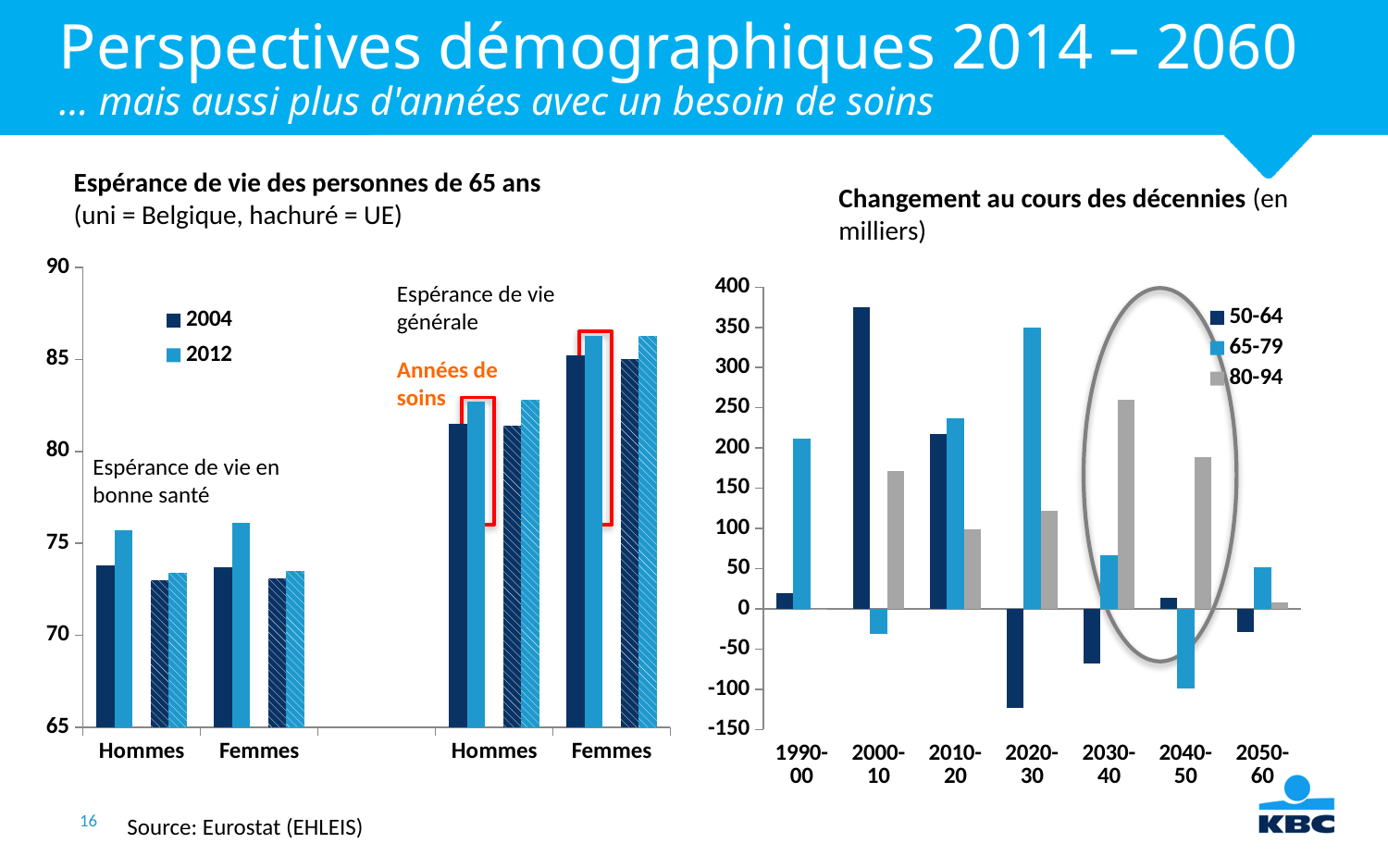
What type of chart is the 'Changement au cours des décennies' chart on the right? bar chart How many series does the legend of the right chart ('Changement au cours des décennies') list? 3 In the right chart ('Changement au cours des décennies'), is the value for the 65-79 series in 2040-50 greater or less than -50? less In the right chart ('Changement au cours des décennies'), which decade has the highest value for the 50-64 series? 2000-10 In the right chart ('Changement au cours des décennies'), which decade has the highest value for the 80-94 series? 2030-40 How many series does the legend of the left chart ('Espérance de vie des personnes de 65 ans') list? 2 In the right chart ('Changement au cours des décennies'), which decade has the lowest value for the 50-64 series? 2020-30 In the right chart ('Changement au cours des décennies'), for the decade 2030-40, which series has the larger value: 65-79 or 80-94? 80-94 In the right chart ('Changement au cours des décennies'), which decade has the highest value for the 65-79 series? 2020-30 How many decades are shown on the x axis of the right chart ('Changement au cours des décennies')? 7 In the right chart ('Changement au cours des décennies'), is the value for the 50-64 series in 2000-10 greater or less than 350? greater In the left chart ('Espérance de vie des personnes de 65 ans'), for the 2012 Belgian general life expectancy (Espérance de vie générale), which is larger: Hommes or Femmes? Femmes